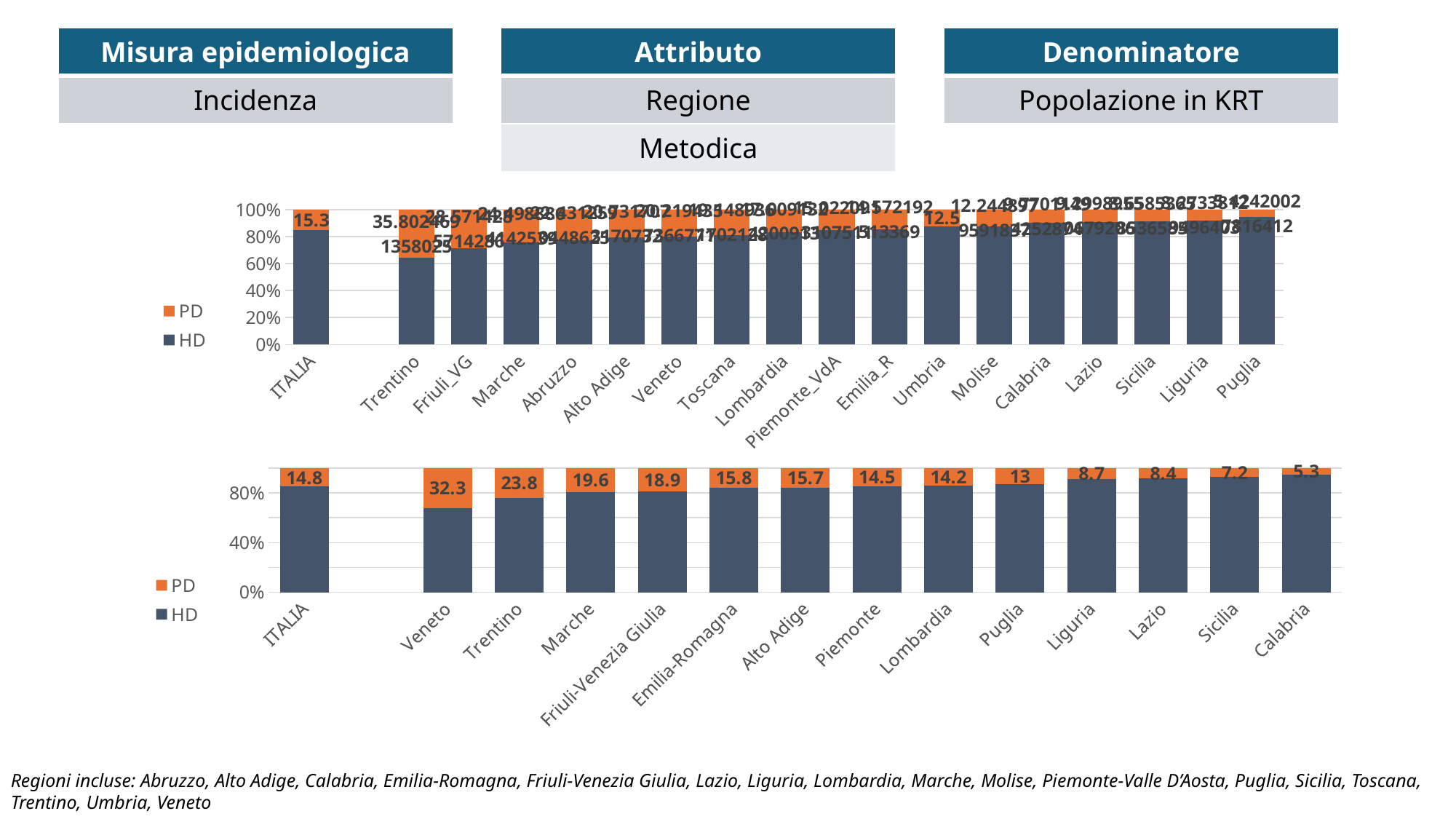
In the bottom chart, what is the PD value for Veneto? 32.3 In the bottom chart, what is the PD value for ITALIA? 14.8 In the bottom chart, which region has the lowest PD value? Calabria In the bottom chart, what is the PD value for Calabria? 5.3 In the top chart, what is the PD value for ITALIA? 15.3 In the top chart, how many categories are shown on the x axis? 18 In the bottom chart, which region has the highest PD value? Veneto In the bottom chart, what is the difference between the PD values of Trentino and Marche? 4.2 In the bottom chart, do the PD values rise or fall from Veneto to Calabria along the x axis? fall What kind of chart is the top chart? stacked bar chart In the bottom chart, how many regions (including ITALIA) are shown on the x axis? 14 In the bottom chart, which has a larger PD value, Liguria or Lazio? Liguria